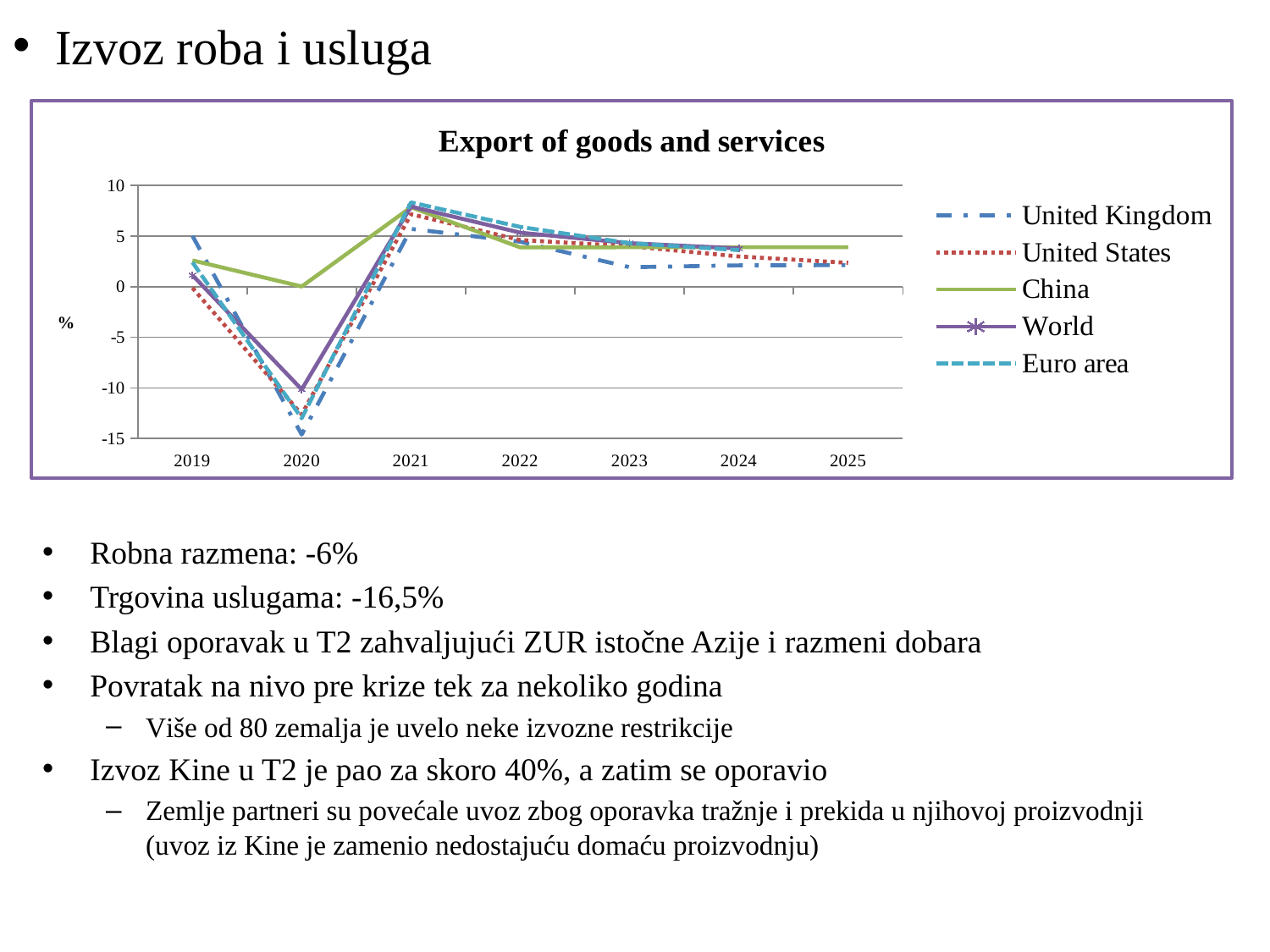
What is the title of the chart? Export of goods and services Is the value for China in 2020 greater or less than -5? greater Which series has the highest value in 2020? China Which series has the lowest value in 2020? United Kingdom How many years are shown on the x axis of the chart? 7 Is the value for United Kingdom in 2020 greater or less than -10? less Is the value for United Kingdom in 2023 greater or less than 5? less Does the value for China rise or fall from 2019 to 2020? fall How many series does the chart legend list? 5 What kind of chart is shown on the slide? line chart In 2023, which is larger: the value for China or the value for United Kingdom? China